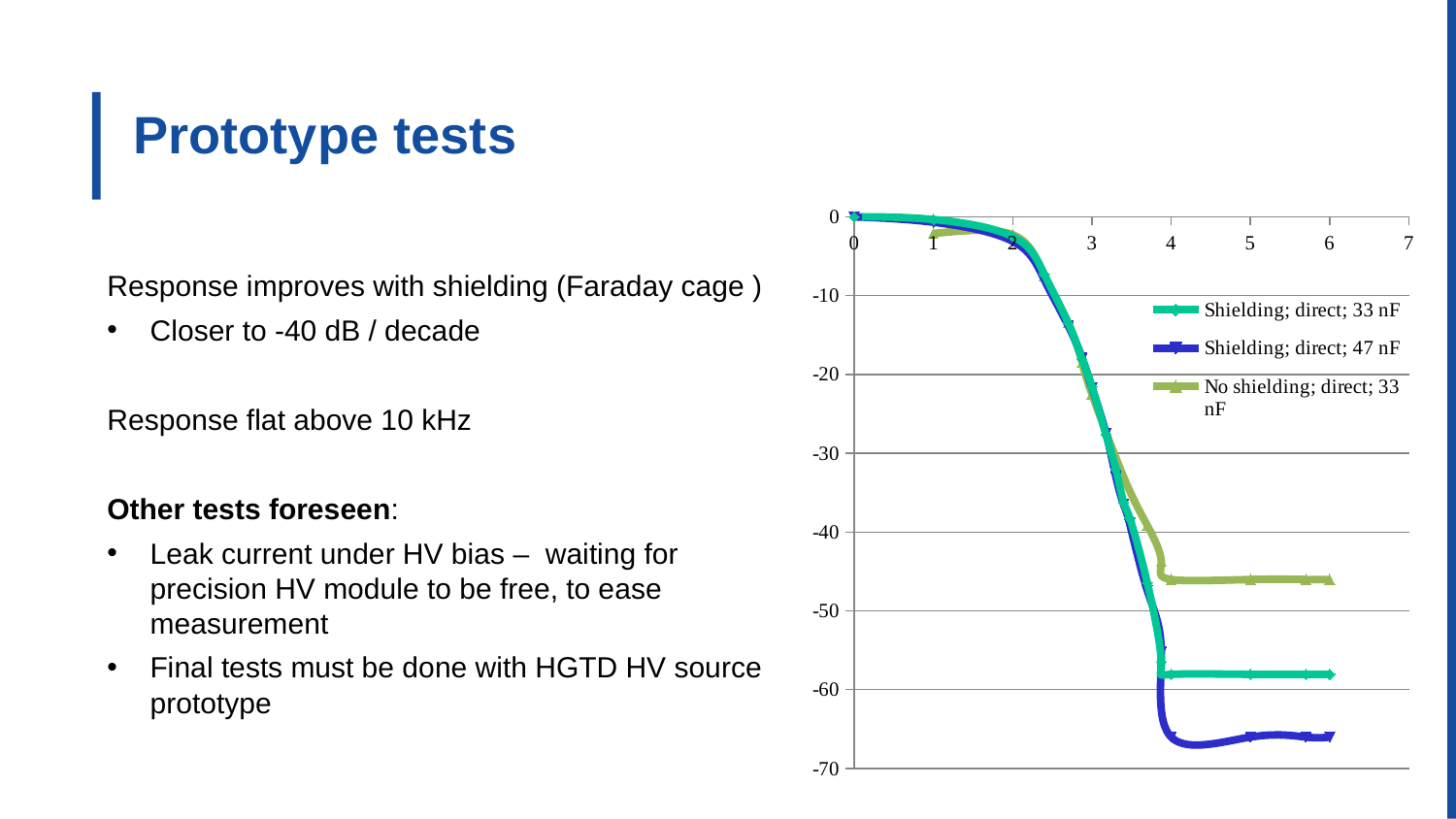
How many series does the legend list? 3 Is the value of the 'No shielding; direct; 33 nF' series at x = 6 greater or less than -40? less Is the value of the 'Shielding; direct; 33 nF' series at x = 6 greater or less than -60? greater Which series has the lowest value at x = 6? Shielding; direct; 47 nF Which series has the highest value at x = 6? No shielding; direct; 33 nF Do the plotted values rise or fall as the x axis increases from 0 to 6? fall Is the value of the 'No shielding; direct; 33 nF' series at x = 6 greater or less than -50? greater What are the three series named in the legend? Shielding; direct; 33 nF, Shielding; direct; 47 nF, No shielding; direct; 33 nF What kind of chart is shown on the slide? line chart At x = 6, which series has the larger value: 'Shielding; direct; 33 nF' or 'Shielding; direct; 47 nF'? Shielding; direct; 33 nF